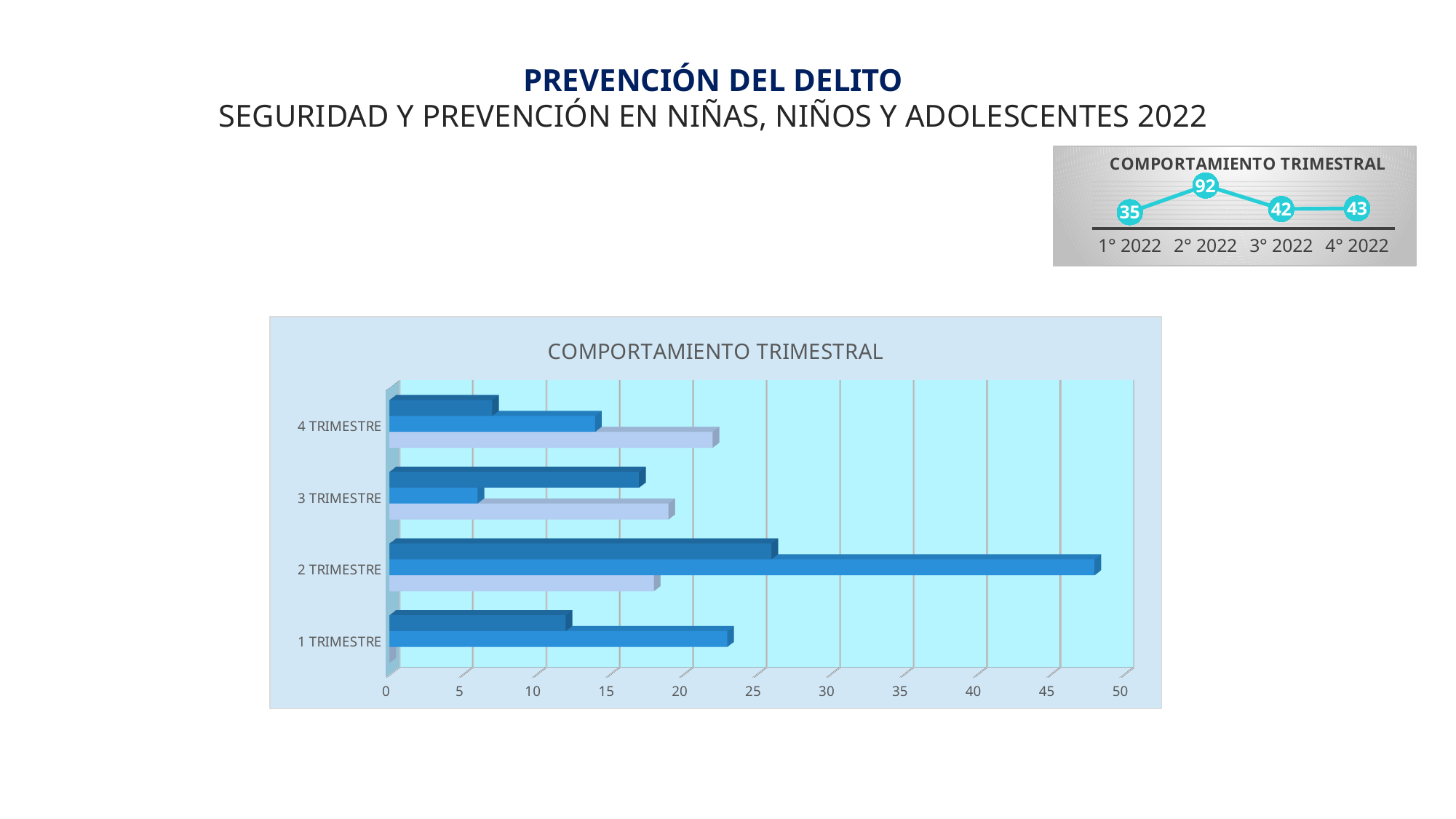
In the top-right line chart titled COMPORTAMIENTO TRIMESTRAL, what is the value for 1° 2022? 35 In the top-right line chart, which is larger, the value for 3° 2022 or the value for 4° 2022? 4° 2022 In the top-right line chart, which quarter has the highest value? 2° 2022 How many data points are plotted in the top-right line chart? 4 In the top-right line chart titled COMPORTAMIENTO TRIMESTRAL, what is the value for 4° 2022? 43 In the large bar chart, which category contains the longest bar? 2 TRIMESTRE How many categories are shown on the vertical axis of the large bar chart? 4 In the top-right line chart, what is the difference between the values for 2° 2022 and 3° 2022? 50 What kind of chart is the large chart in the lower part of the slide? Bar chart In the top-right line chart, which quarter has the lowest value? 1° 2022 In the large bar chart, is the longest bar for 2 TRIMESTRE greater or less than 45? greater In the top-right line chart titled COMPORTAMIENTO TRIMESTRAL, what is the value for 2° 2022? 92